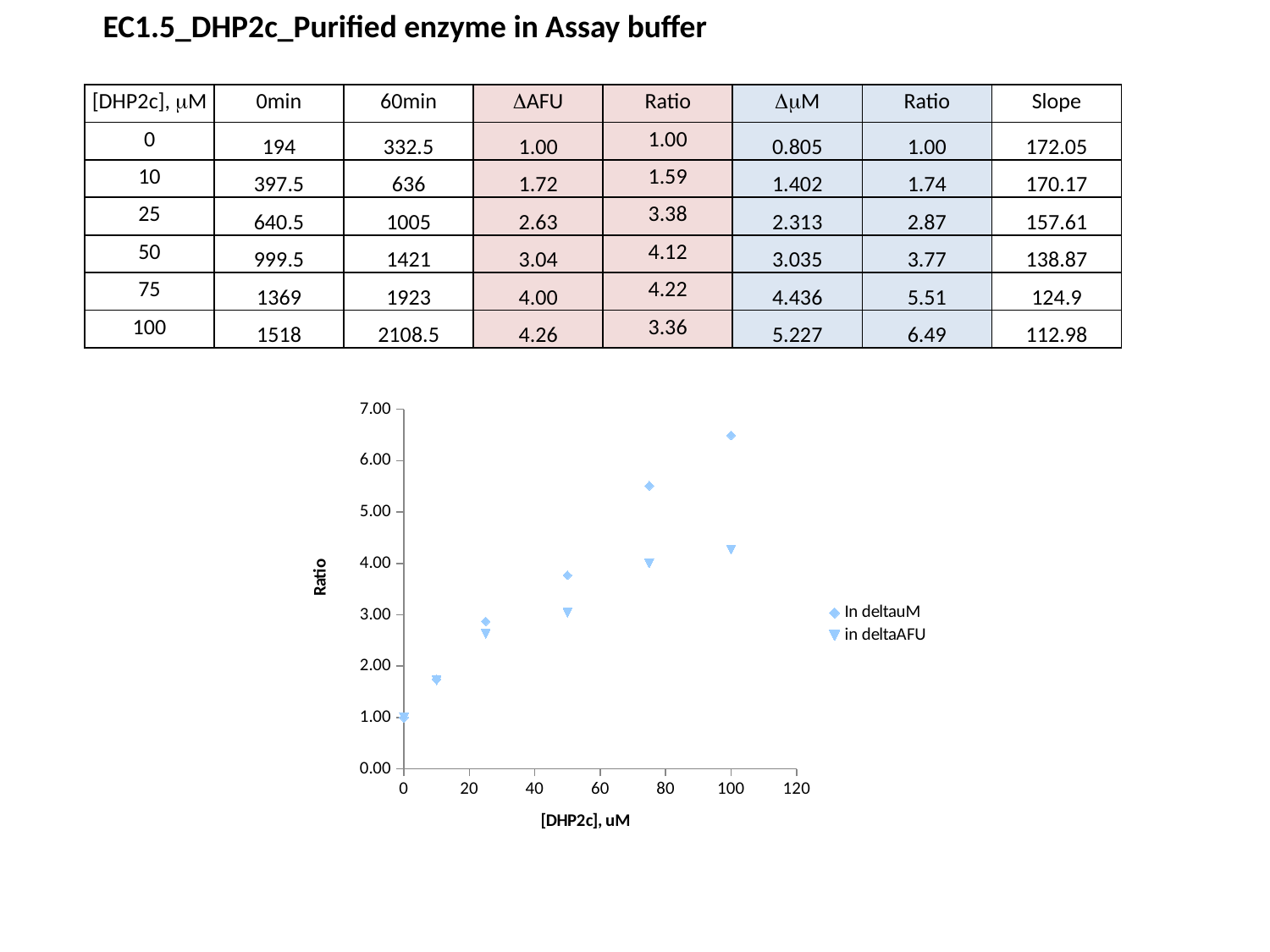
What are the two series named in the chart legend? In deltauM and in deltaAFU Is the In deltauM value at [DHP2c] = 100 greater or less than 6.00? greater How many data points are plotted for the In deltauM series? 6 Is the in deltaAFU value at [DHP2c] = 25 greater or less than 3.00? less How many series does the chart legend list? 2 What is the title of the chart's y axis? Ratio Is the in deltaAFU value at [DHP2c] = 100 greater or less than 5.00? less At [DHP2c] = 100, which series has the larger ratio, In deltauM or in deltaAFU? In deltauM At which [DHP2c] value does the In deltauM series reach its highest ratio? 100 Do the In deltauM values rise or fall as [DHP2c] increases along the x axis? rise What kind of chart is shown on the slide? scatter chart